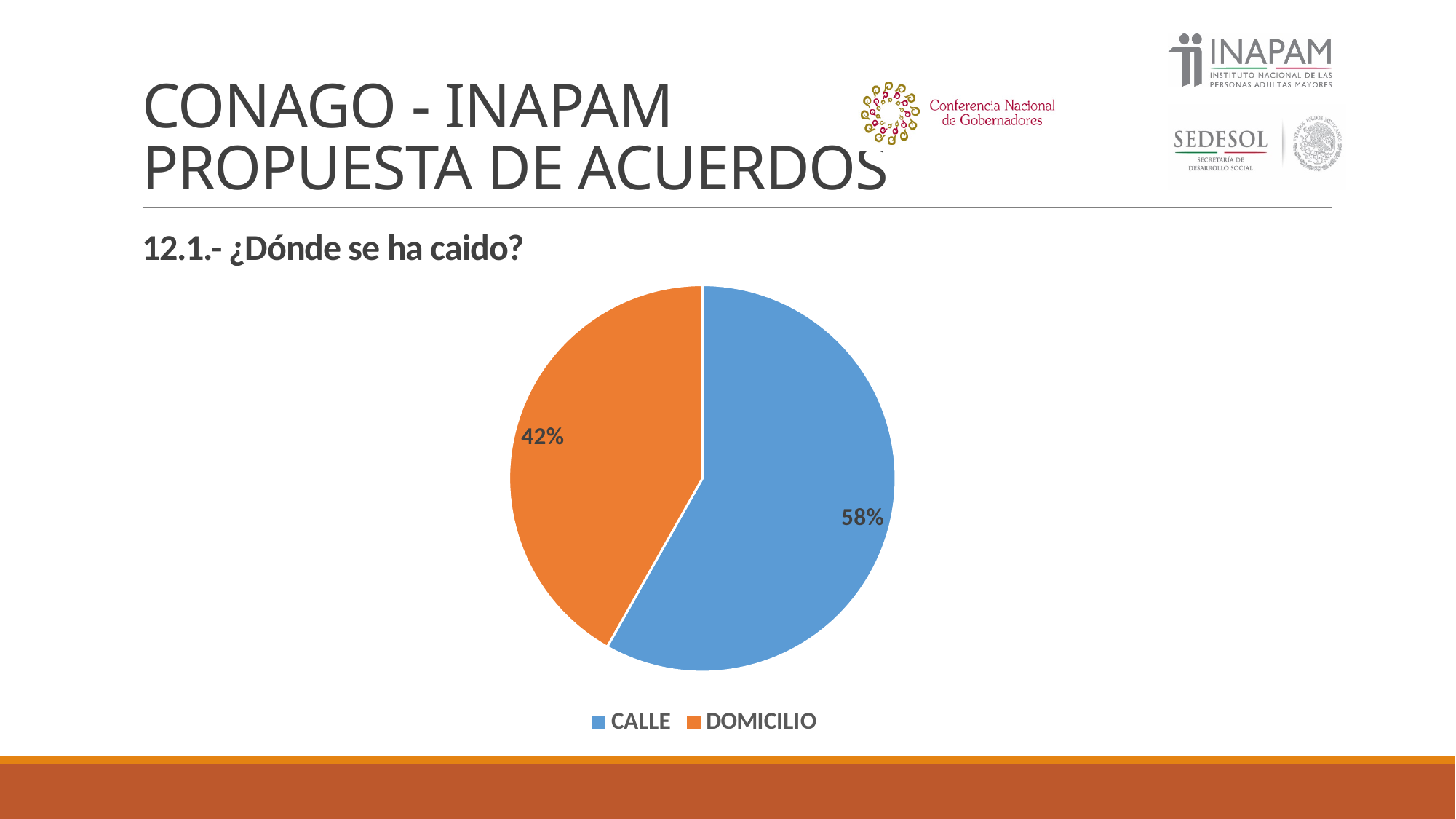
What is the share of the pie taken by the DOMICILIO slice? 42% What is the question heading above the chart? 12.1.- ¿Dónde se ha caido? What is the difference in percentage points between CALLE and DOMICILIO? 16 What percentage of the pie chart is CALLE? 58% Which category has the smallest share of the pie chart? DOMICILIO Is the share for CALLE greater or less than 50%? greater Which category has the largest share of the pie chart? CALLE What kind of chart is shown on the slide? Pie chart What colour is the CALLE slice in the pie chart? Blue What percentage of the pie chart is DOMICILIO? 42% How many categories are shown in the pie chart? 2 Which is larger, the share for CALLE or the share for DOMICILIO? CALLE